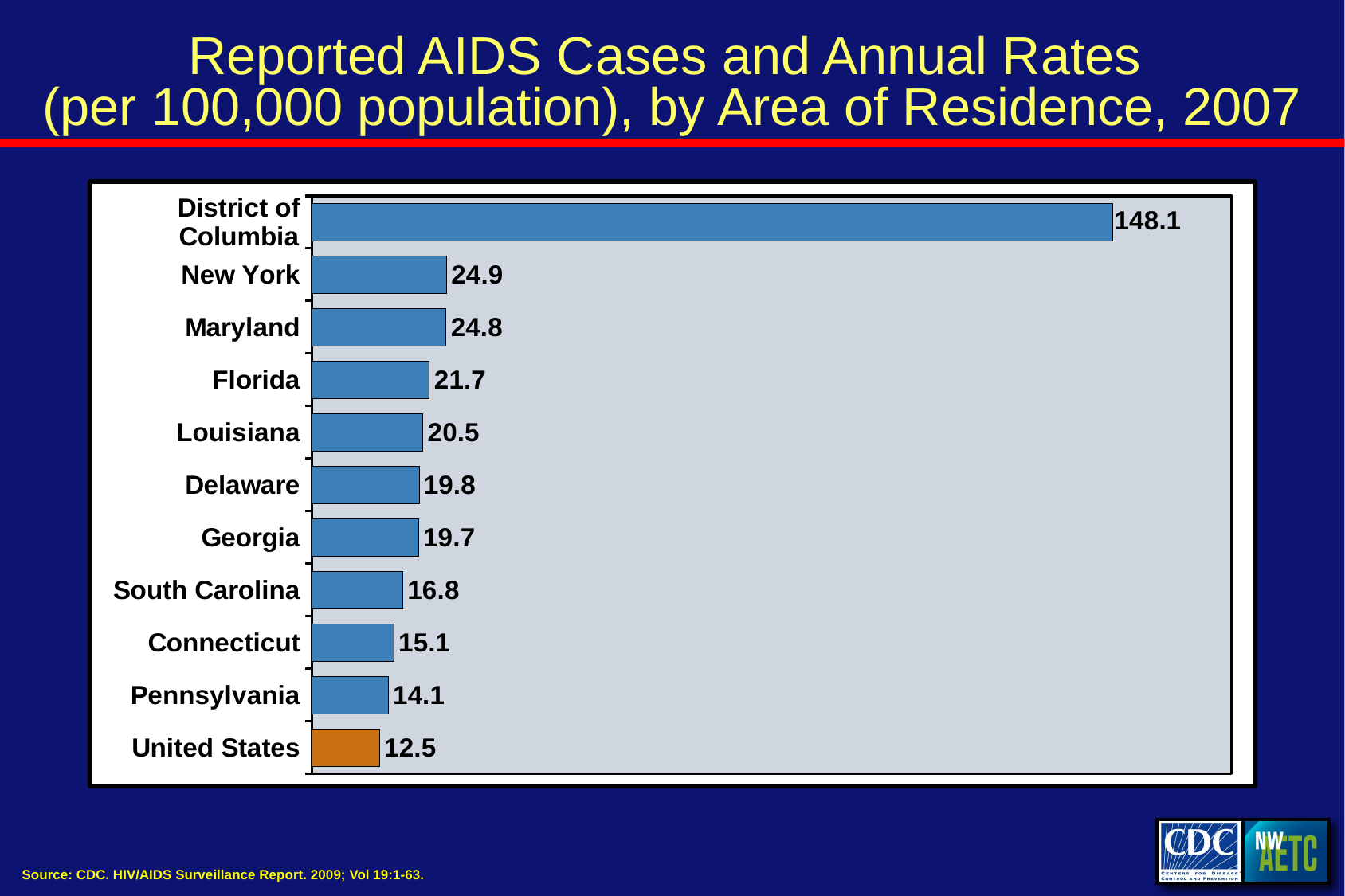
What kind of chart is shown on the slide? Bar chart What is the difference between the rates for New York and Pennsylvania? 10.8 Which has a higher annual AIDS rate, Connecticut or Georgia? Georgia What is the annual AIDS rate for the United States overall? 12.5 What is the annual AIDS rate for Florida? 21.7 How many areas are shown in the chart? 11 Which area has the highest annual AIDS rate? District of Columbia Which bar is shown in a different colour (orange) from the others? United States Which area has the lowest annual AIDS rate shown? United States Which has a higher annual AIDS rate, Louisiana or South Carolina? Louisiana What is the annual AIDS rate for the District of Columbia? 148.1 What is the difference between the rates for the District of Columbia and the United States? 135.6